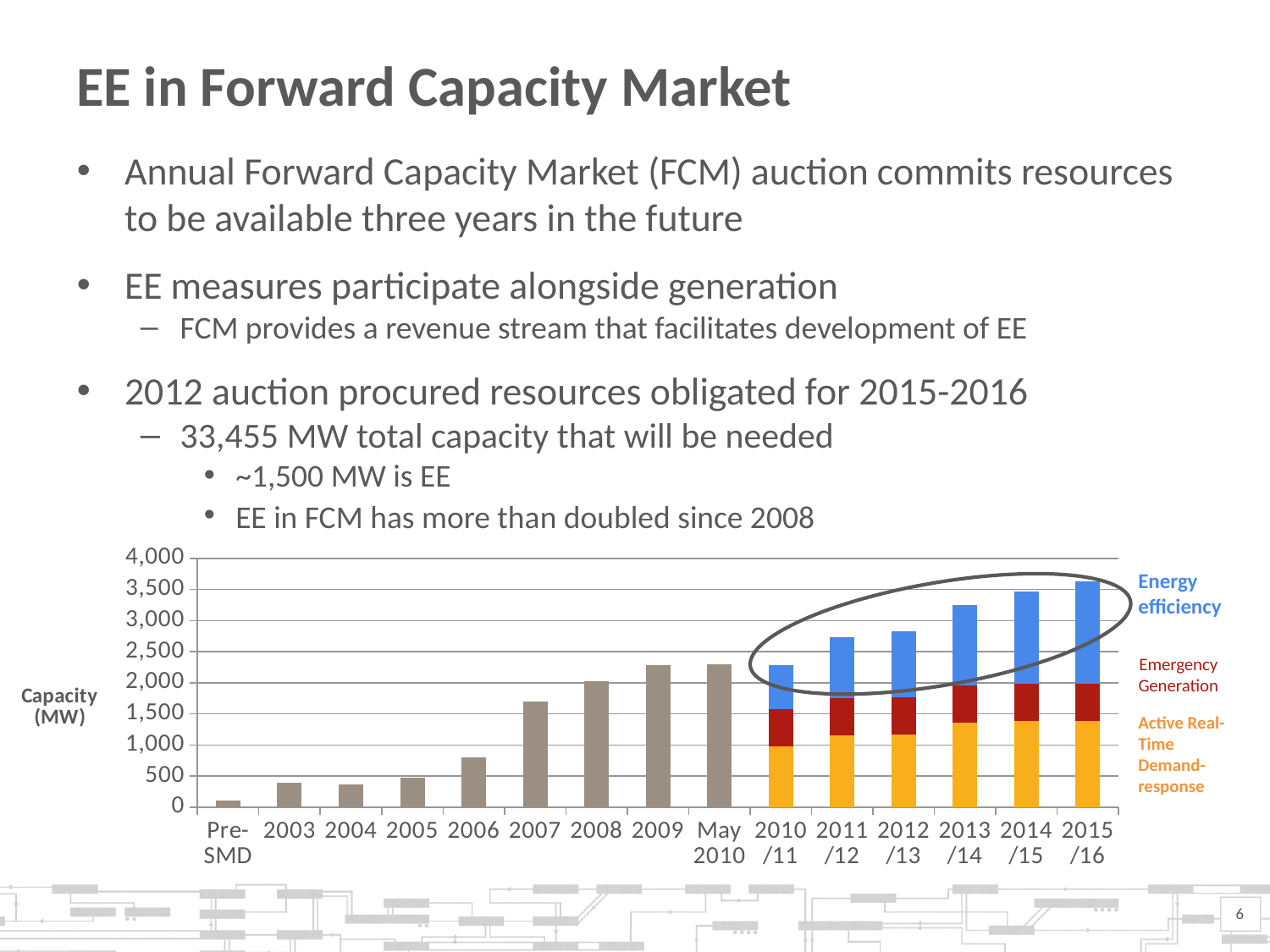
Which category has the tallest bar in the chart? 2015/16 Which colour represents Energy efficiency in the stacked bars? blue Is the value for 2007 greater or less than 1,500? greater What kind of chart is shown on the slide? bar chart How many categories are shown along the x axis of the chart? 15 Is the total value for 2015/16 greater or less than 3,000? greater Which category has the shortest bar in the chart? Pre-SMD Is the value for 2003 greater or less than 500? less What is the label on the vertical axis of the chart? Capacity (MW) Which is larger, the value for 2009 or the value for 2005? 2009 Do the bar values generally rise or fall from 2003 to 2015/16? rise